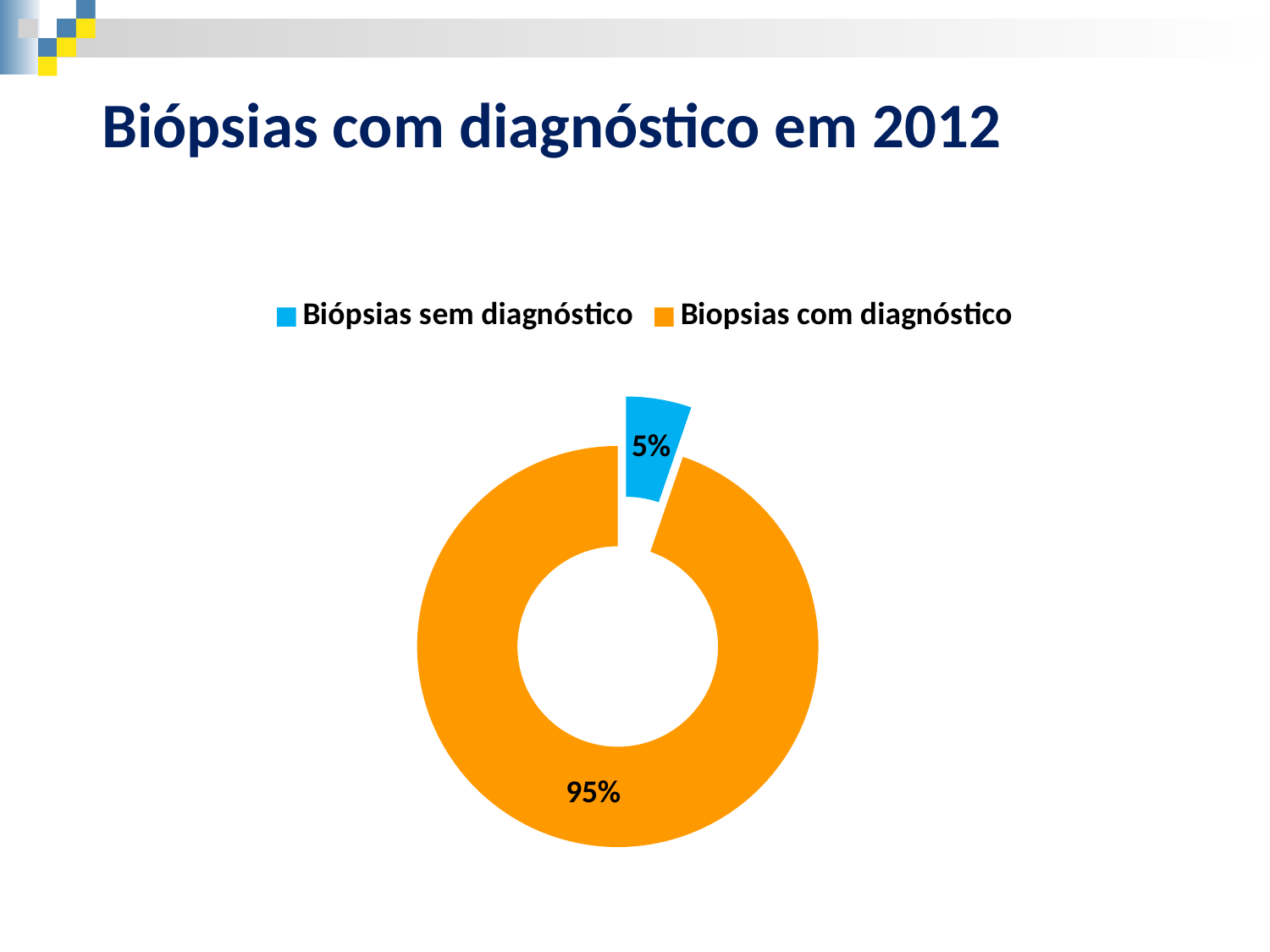
How many categories does the chart show? 2 What is the difference in percentage points between 'Biopsias com diagnóstico' and 'Biópsias sem diagnóstico'? 90 percentage points What kind of chart is shown on the slide? Doughnut (pie) chart What colour is the slice for 'Biópsias sem diagnóstico'? Blue Which is larger: the slice for 'Biópsias sem diagnóstico' or the slice for 'Biopsias com diagnóstico'? Biopsias com diagnóstico What share of the doughnut chart is 'Biopsias com diagnóstico'? 95% Which category has the largest slice in the chart? Biopsias com diagnóstico What is the title of the slide? Biópsias com diagnóstico em 2012 What is the total of the two percentages shown on the chart? 100% Which category has the smallest slice in the chart? Biópsias sem diagnóstico What share of the doughnut chart is 'Biópsias sem diagnóstico'? 5%